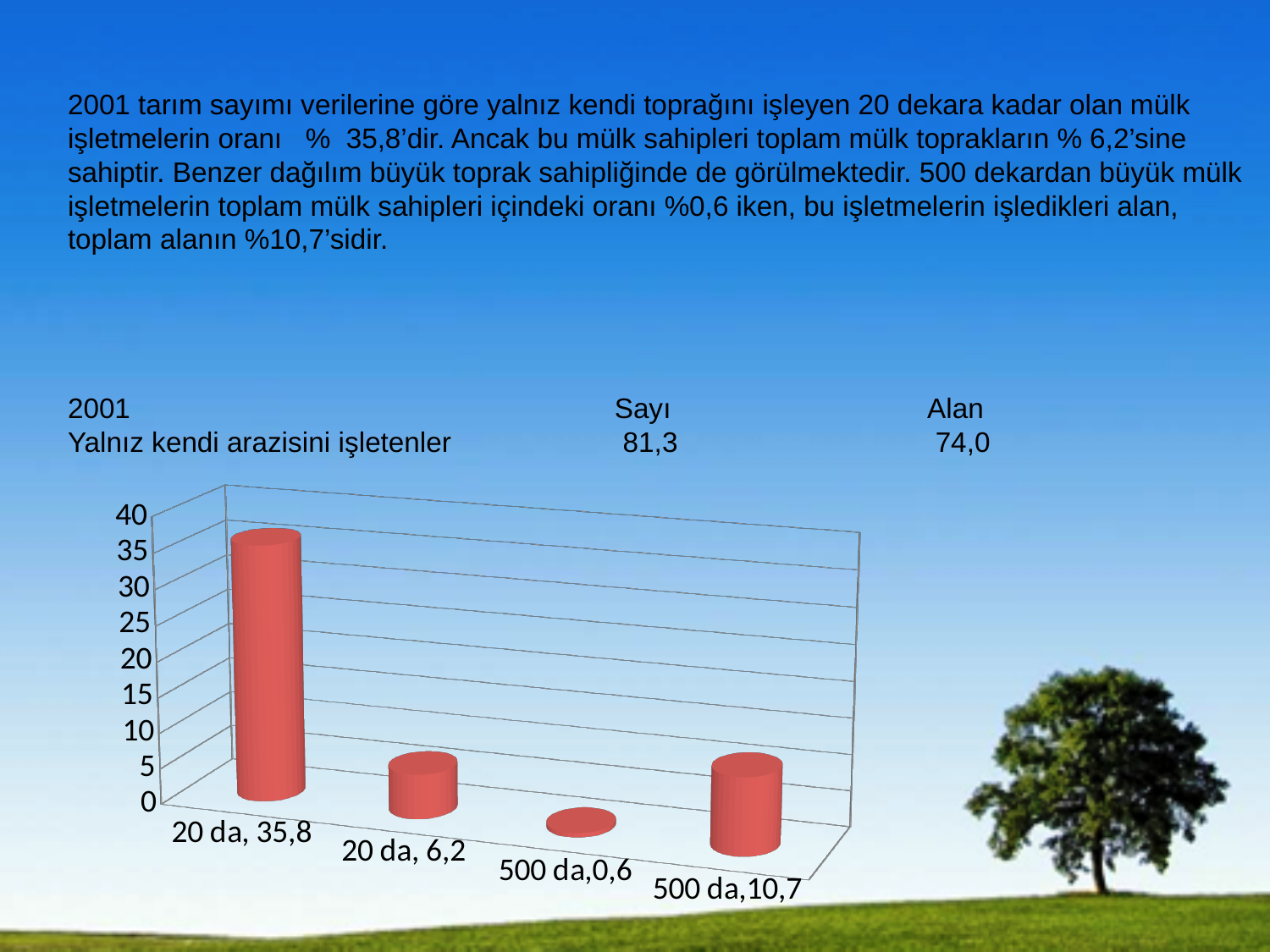
How many bars does the chart show? 4 Which bar is taller: '20 da, 6,2' or '500 da,10,7'? 500 da,10,7 What kind of chart is shown on the slide? bar chart Which category has the tallest bar? 20 da, 35,8 What is the difference between the values of '20 da, 35,8' and '20 da, 6,2'? 29,6 What is the highest value shown on the vertical axis? 40 What value is given in the label of the last bar, '500 da,10,7'? 10,7 What colour are the bars in the chart? red Is the value of the first bar ('20 da, 35,8') greater or less than 30? greater Is the value of the bar labelled '20 da, 6,2' greater or less than 10? less Which category has the shortest bar? 500 da,0,6 What value is given in the label of the first bar, '20 da, 35,8'? 35,8